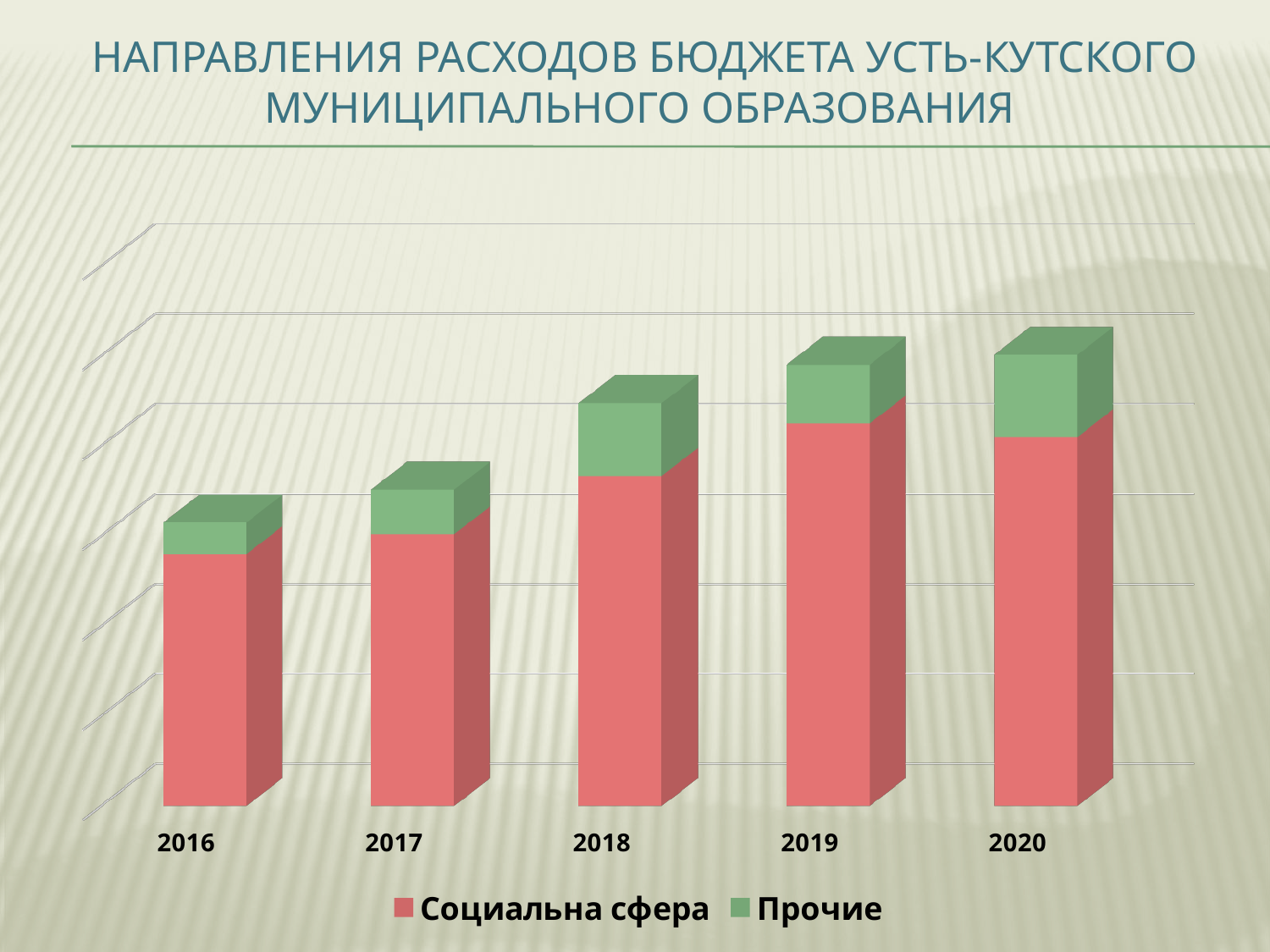
Which year has the lowest total bar in the chart? 2016 Which total bar is taller, 2016 or 2018? 2018 Which series is shown in red in the chart? Социальна сфера What kind of chart is shown on the slide? Stacked bar chart Which year has the larger 'Прочие' segment, 2016 or 2018? 2018 In 2020, which series has the larger segment, 'Социальна сфера' or 'Прочие'? Социальна сфера How many series does the chart legend list? 2 Do the total bar heights rise or fall from 2016 to 2020? Rise Which series is shown in green in the chart? Прочие How many years are shown on the x axis of the chart? 5